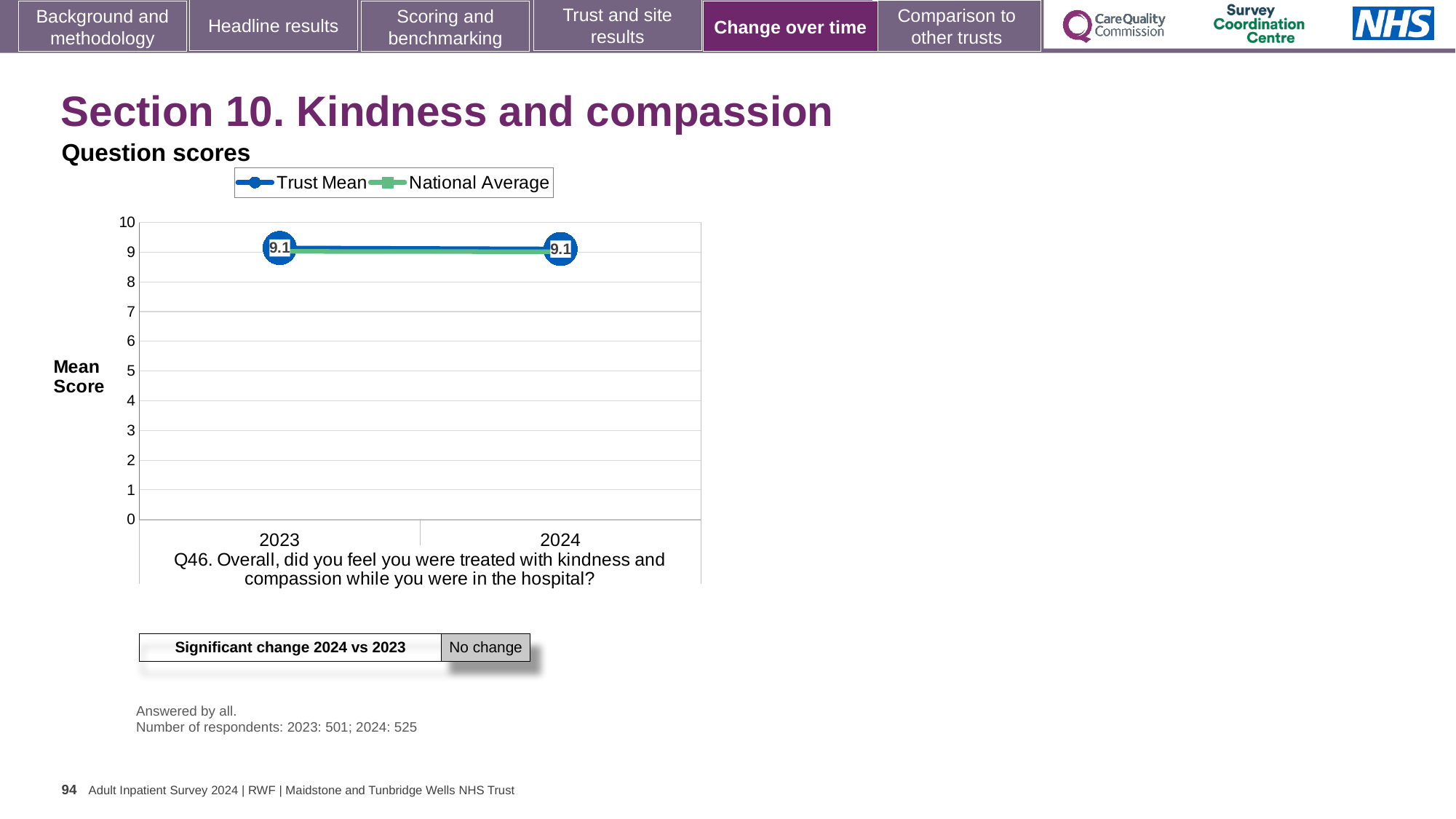
What is the label on the y axis of the chart? Mean Score Is the National Average value for 2024 greater or less than 5? greater Which series is shown in green in the chart legend? National Average How many years are shown on the x axis of the chart? 2 What kind of chart is shown on the slide? line chart What is the Trust Mean value for 2023? 9.1 Does the Trust Mean rise, fall or stay the same from 2023 to 2024? stays the same What is the Trust Mean value for 2024? 9.1 What is the difference between the Trust Mean values for 2024 and 2023? 0 How many series does the chart legend list? 2 What is the maximum value shown on the y axis of the chart? 10 Is the Trust Mean value for 2023 greater or less than 8? greater